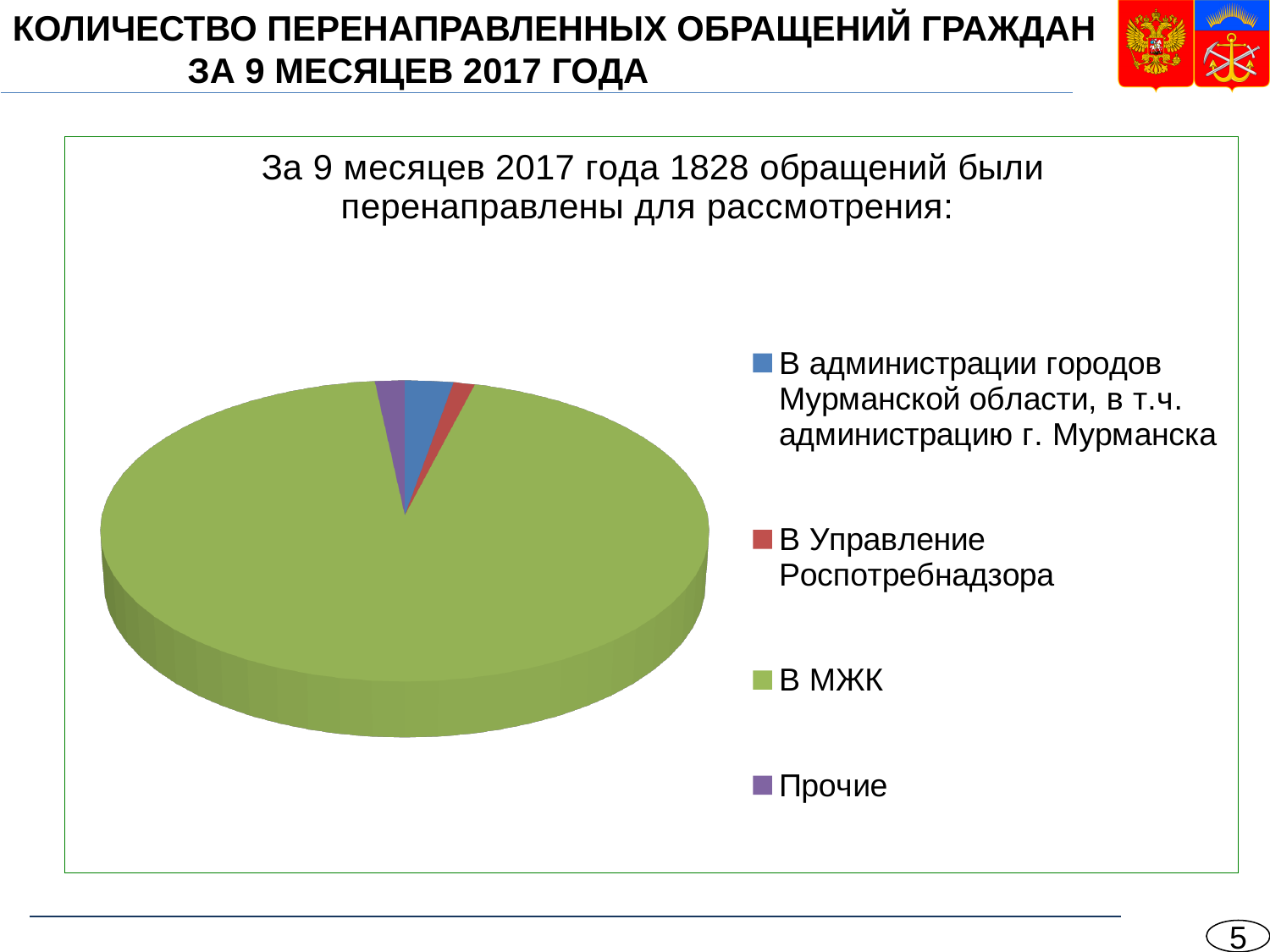
According to the text above the chart, how many appeals were redirected for consideration over 9 months of 2017? 1828 What colour is the 'Прочие' slice in the pie chart? purple Which slice is larger: 'В администрации городов Мурманской области, в т.ч. администрацию г. Мурманска' or 'В Управление Роспотребнадзора'? В администрации городов Мурманской области, в т.ч. администрацию г. Мурманска Does the 'В МЖК' slice take up more or less than half of the pie chart? more What kind of chart is shown on the slide? pie chart What colour is the 'В МЖК' slice in the pie chart? green Which slice is larger: 'В МЖК' or 'В администрации городов Мурманской области, в т.ч. администрацию г. Мурманска'? В МЖК Which category has the largest slice of the pie chart? В МЖК How many categories does the pie chart's legend list? 4